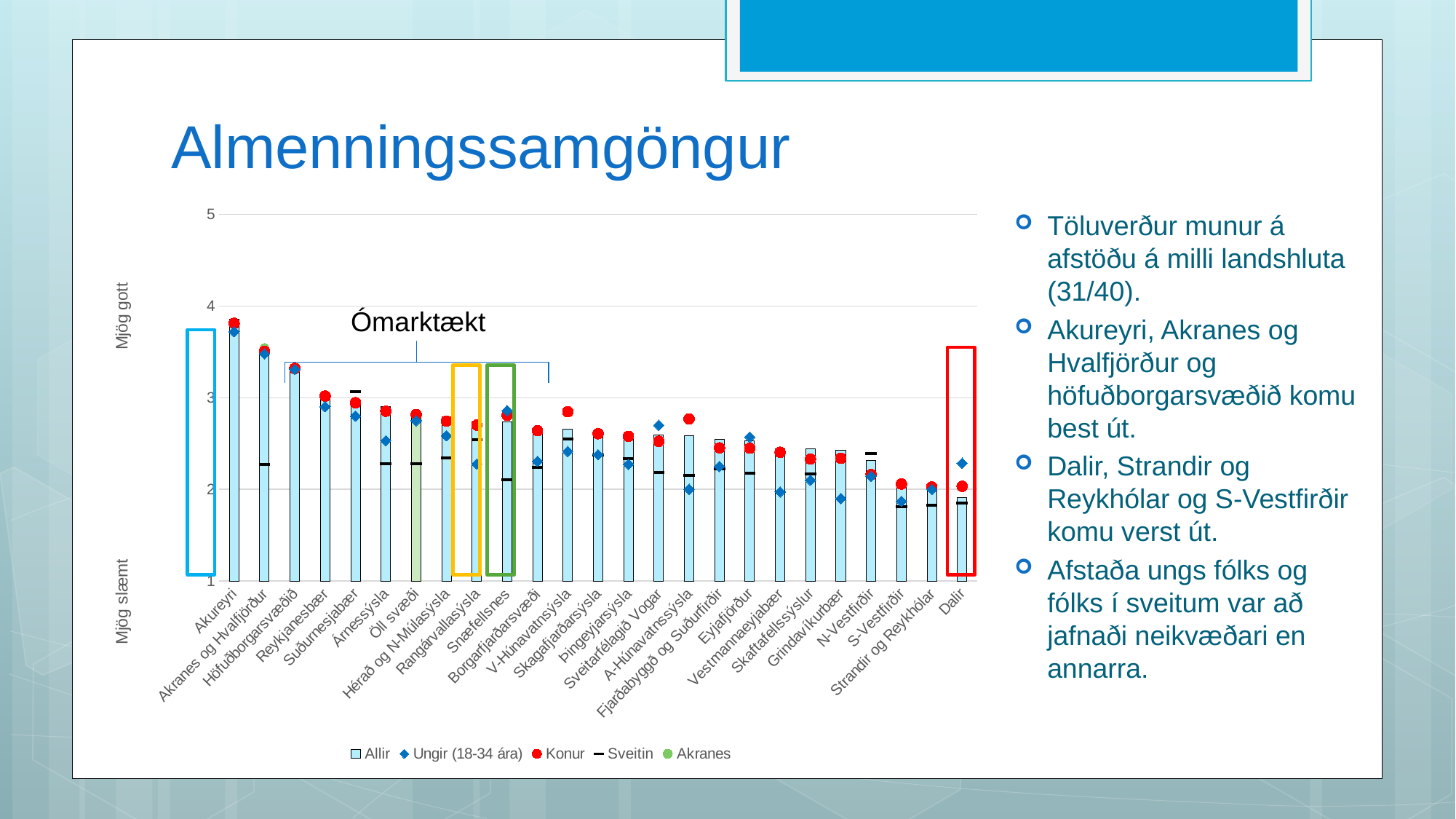
Which region has the lowest Allir bar in the chart? Dalir What is the title of the slide containing the chart? Almenningssamgöngur Is the Allir value for Dalir greater or less than 2? less Is the Allir value for Strandir og Reykhólar greater or less than 3? less Which has the larger Allir value, Akureyri or Dalir? Akureyri Which region has the highest Allir bar in the chart? Akureyri Is the Allir value for Höfuðborgarsvæðið greater or less than 3? greater How many categories (regions) are plotted along the x axis of the chart? 25 How many series does the chart's legend list? 5 What kind of chart is shown on the slide? bar chart Do the Allir bar values generally rise or fall from left to right along the x axis? fall